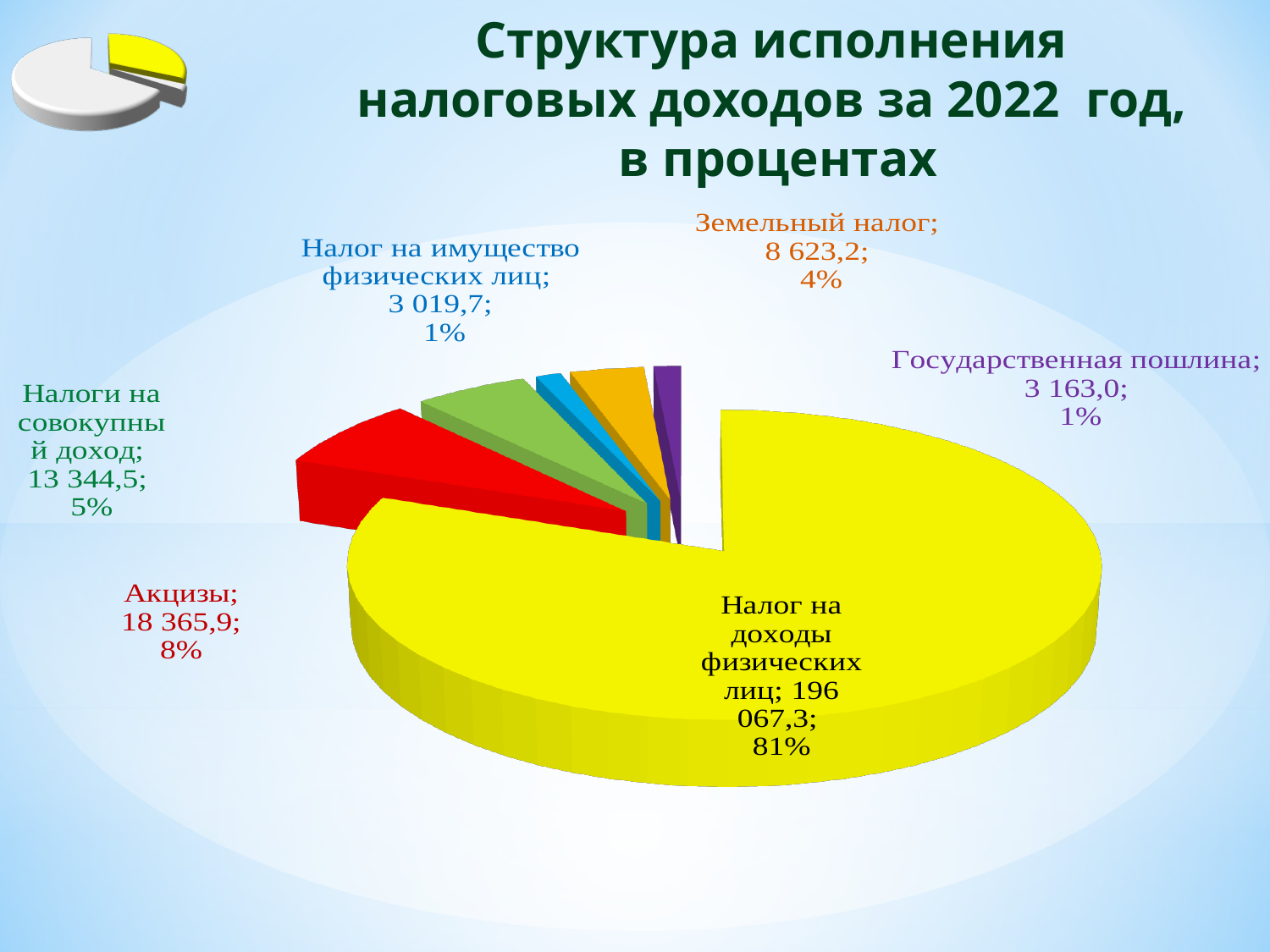
What percentage is shown for Налоги на совокупный доход? 5% Which is larger, Акцизы or Налоги на совокупный доход? Акцизы What share of the pie does Налог на доходы физических лиц represent? 81% How many slices does the pie chart have? 6 What is the difference between the values for Акцизы and Налоги на совокупный доход? 5 021,4 What is the value shown for Земельный налог? 8 623,2 What is the value shown for Государственная пошлина? 3 163,0 What kind of chart is shown on the slide? Pie chart Which category has the largest slice of the pie? Налог на доходы физических лиц What is the difference between the values for Земельный налог and Государственная пошлина? 5 460,2 What is the title of the chart on the slide? Структура исполнения налоговых доходов за 2022 год, в процентах What is the value shown for Акцизы? 18 365,9